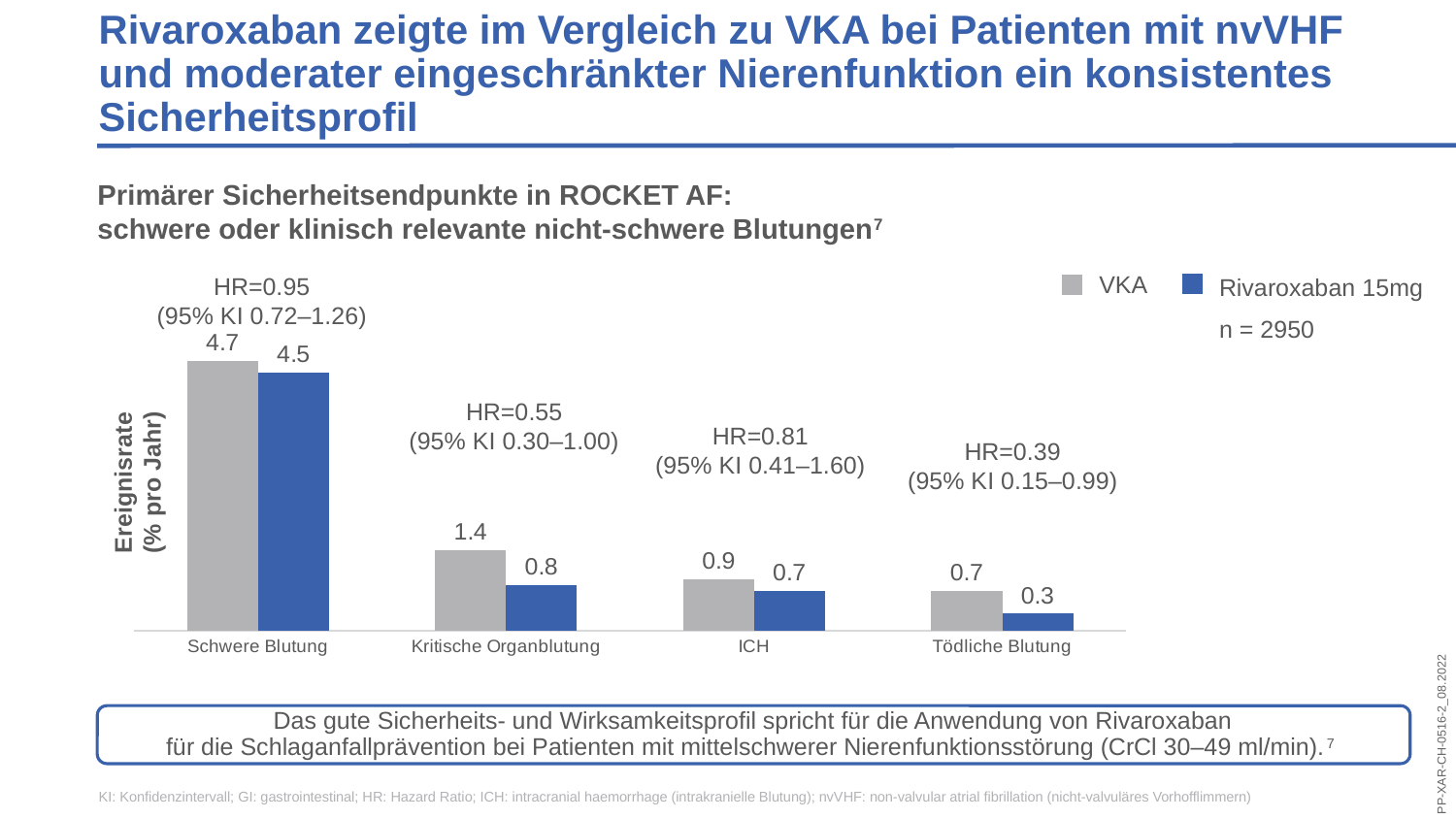
How many categories are shown on the x axis of the chart? 4 In the Tödliche Blutung category, which series has the larger event rate, VKA or Rivaroxaban 15mg? VKA What is the event rate for VKA in the ICH category? 0.9 Which category has the lowest event rate for Rivaroxaban 15mg? Tödliche Blutung What is the event rate for Rivaroxaban 15mg in the Kritische Organblutung category? 0.8 What hazard ratio is shown above the Kritische Organblutung bars? HR=0.55 What kind of chart is shown on the slide? Bar chart What is the event rate for VKA in the Schwere Blutung category? 4.7 How many series does the chart legend list? 2 What is the difference between the VKA and Rivaroxaban 15mg event rates in the Kritische Organblutung category? 0.6 What is the event rate for Rivaroxaban 15mg in the Tödliche Blutung category? 0.3 Which category has the highest event rate for VKA? Schwere Blutung